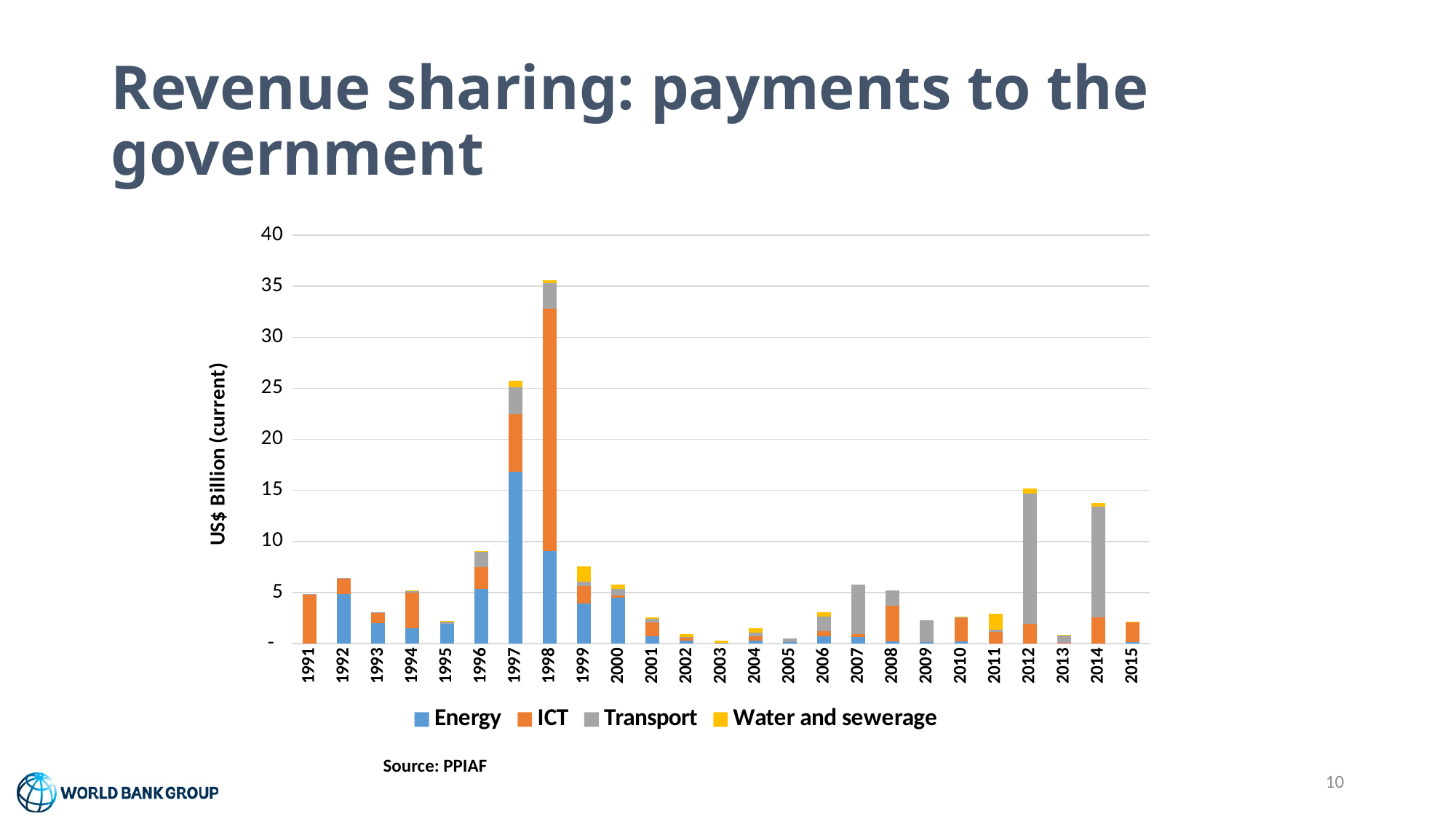
How many years are shown along the x axis? 25 Is the total value for 1998 greater or less than 30? greater Which year has the lowest total payments to the government? 2003 Which year has the larger total, 1997 or 1998? 1998 Is the total value for 2012 greater or less than 10? greater What is the label on the vertical axis? US$ Billion (current) Which year has the larger total, 2008 or 2012? 2012 How many series does the legend list? 4 Is the Energy value for 1997 greater or less than 15? greater Which year has the highest total payments to the government? 1998 What kind of chart is shown on the slide? Stacked bar chart